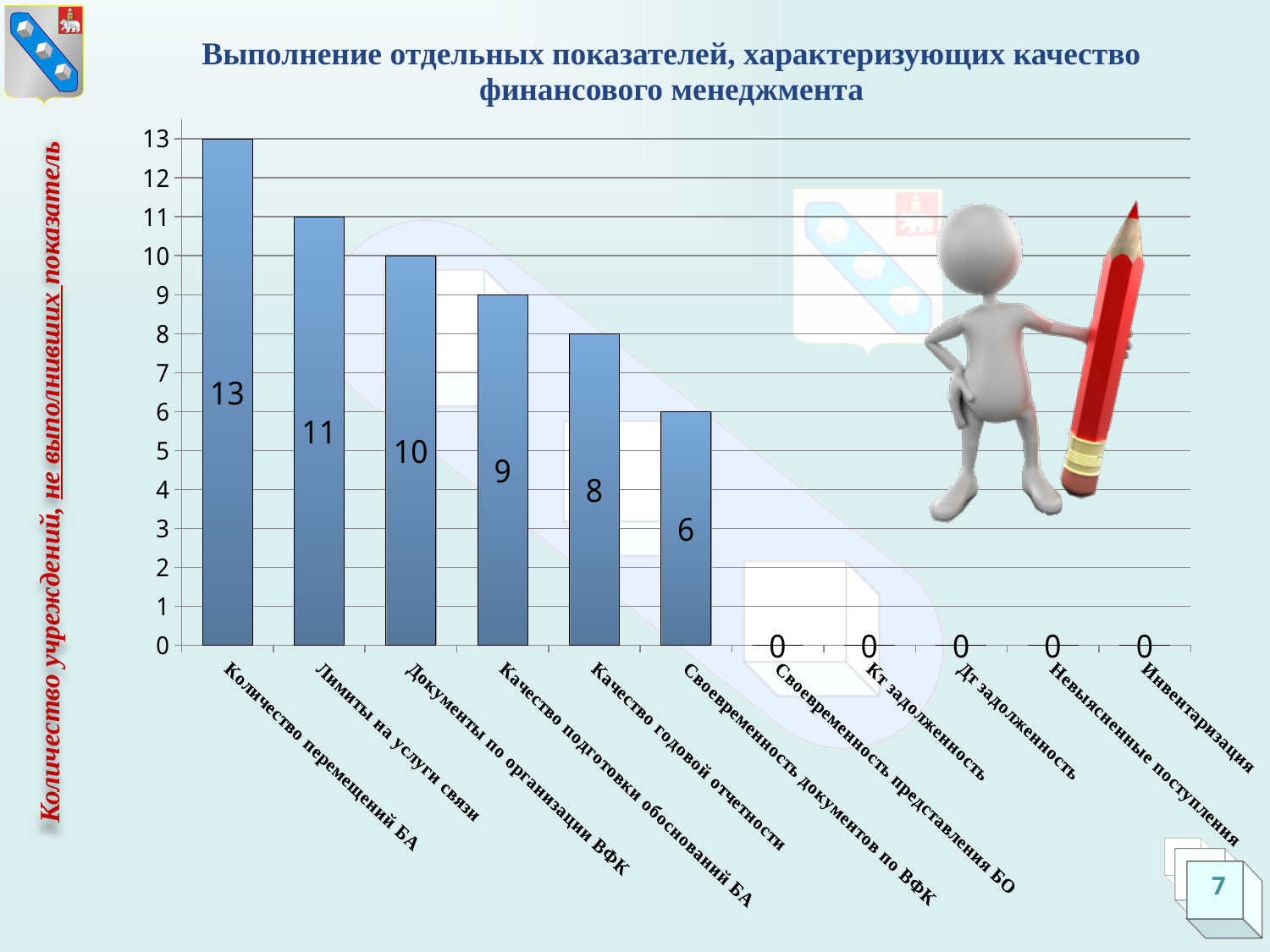
What is the value for "Количество перемещений БА"? 13 How many categories have a value of 0? 5 What is the label on the vertical axis of the chart? Количество учреждений, не выполнивших показатель Which category has the highest value? Количество перемещений БА Do the values rise or fall from left to right along the x axis? Fall What is the value for "Своевременность документов по ВФК"? 6 How many categories are shown on the x axis? 11 What is the value for "Качество годовой отчетности"? 8 What kind of chart is shown on the slide? Bar chart What is the value for "Инвентаризация"? 0 What is the difference between the values for "Лимиты на услуги связи" and "Качество подготовки обоснований БА"? 2 Which is larger, the value for "Документы по организации ВФК" or the value for "Качество годовой отчетности"? Документы по организации ВФК